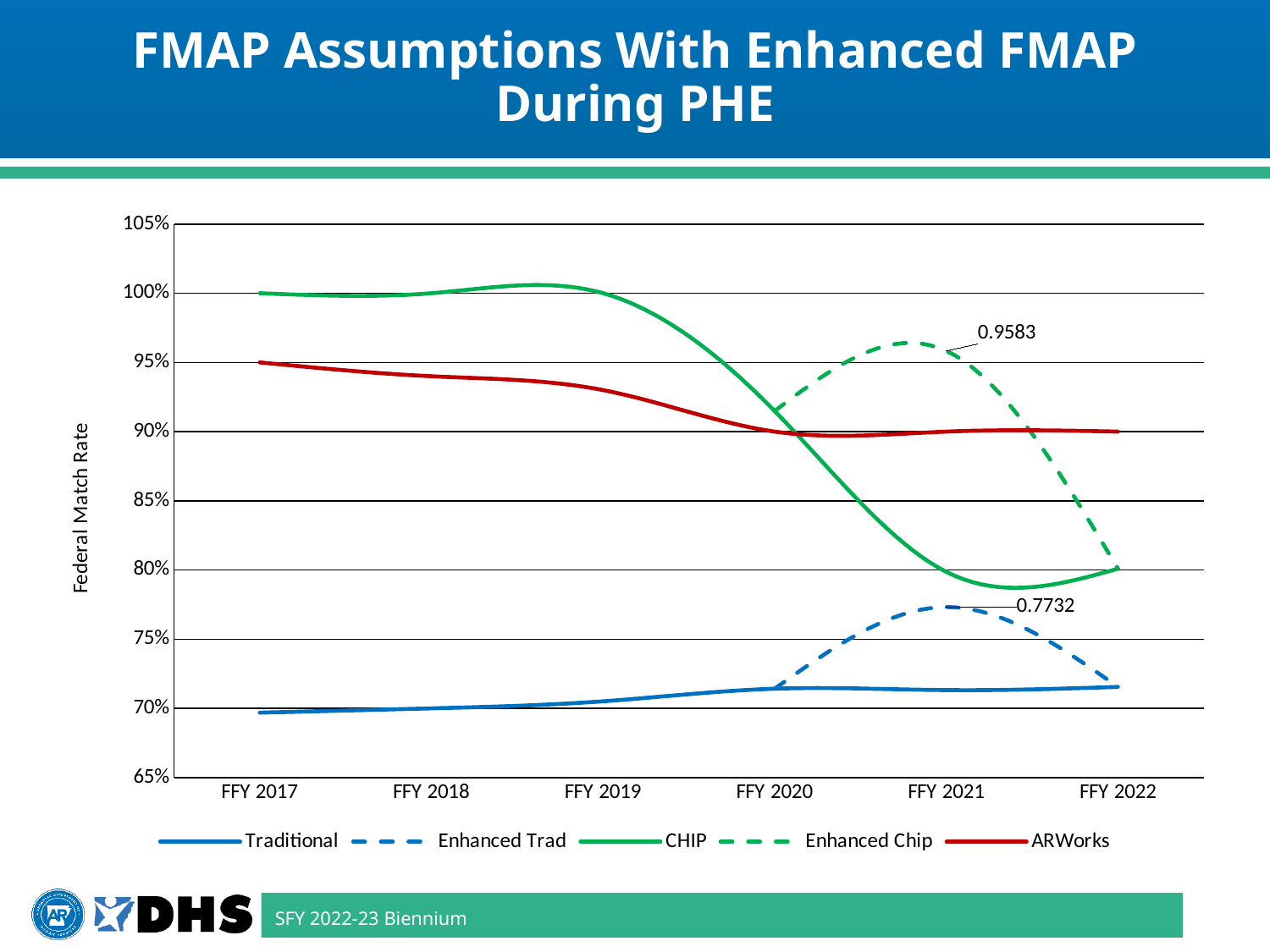
Which series has the highest value at FFY 2017? CHIP Is the value for Traditional at FFY 2017 greater or less than 75%? less What is the title of the y axis? Federal Match Rate How many fiscal years are shown on the x axis? 6 What is the labeled value for Enhanced Chip at FFY 2021? 0.9583 Is the value for CHIP at FFY 2017 greater or less than 95%? greater Does the CHIP line rise or fall from FFY 2019 to FFY 2021? fall Which series has the lowest value at FFY 2017? Traditional What kind of chart is shown on the slide? line chart Is the value for ARWorks at FFY 2022 greater or less than 85%? greater How many series does the legend list? 5 What is the labeled value for Enhanced Trad at FFY 2021? 0.7732